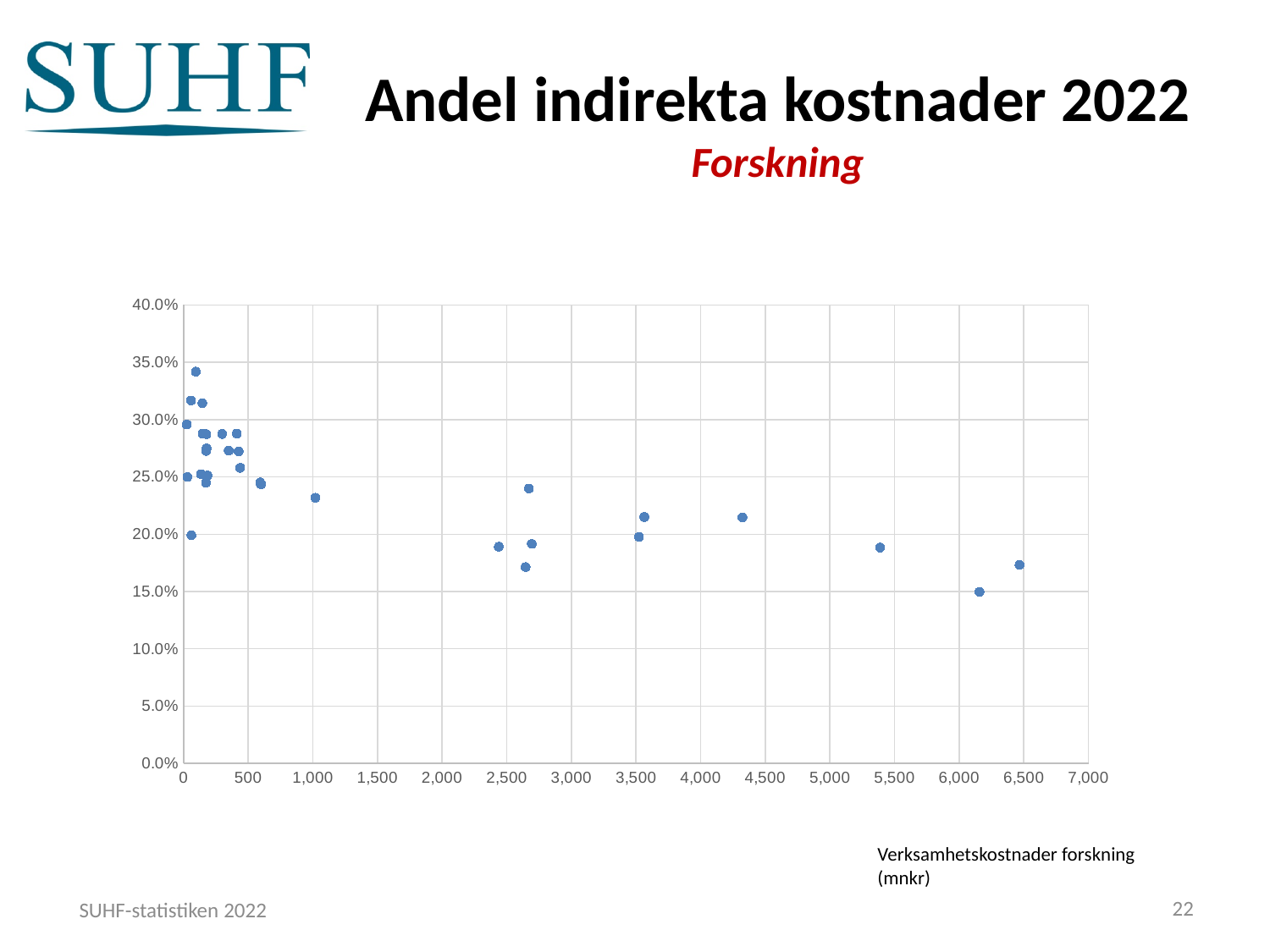
What kind of chart is shown on the slide? scatter chart Which is larger: the value of the point near 4,300 on the x axis or the value of the point near 6,150 on the x axis? the point near 4,300 Is the lowest point on the chart located below 1,000 or above 6,000 on the x axis? above 6,000 Is the value of the highest point on the chart greater or less than 30.0%? greater Is the value of the point near 5,400 on the x axis greater or less than 20.0%? less Do the plotted values generally rise or fall as the x-axis value (Verksamhetskostnader forskning) increases? fall Is the value of the point near 1,000 on the x axis greater or less than 25.0%? less What is the title of the chart on the slide? Andel indirekta kostnader 2022 What label is given for the x axis of the chart? Verksamhetskostnader forskning (mnkr)